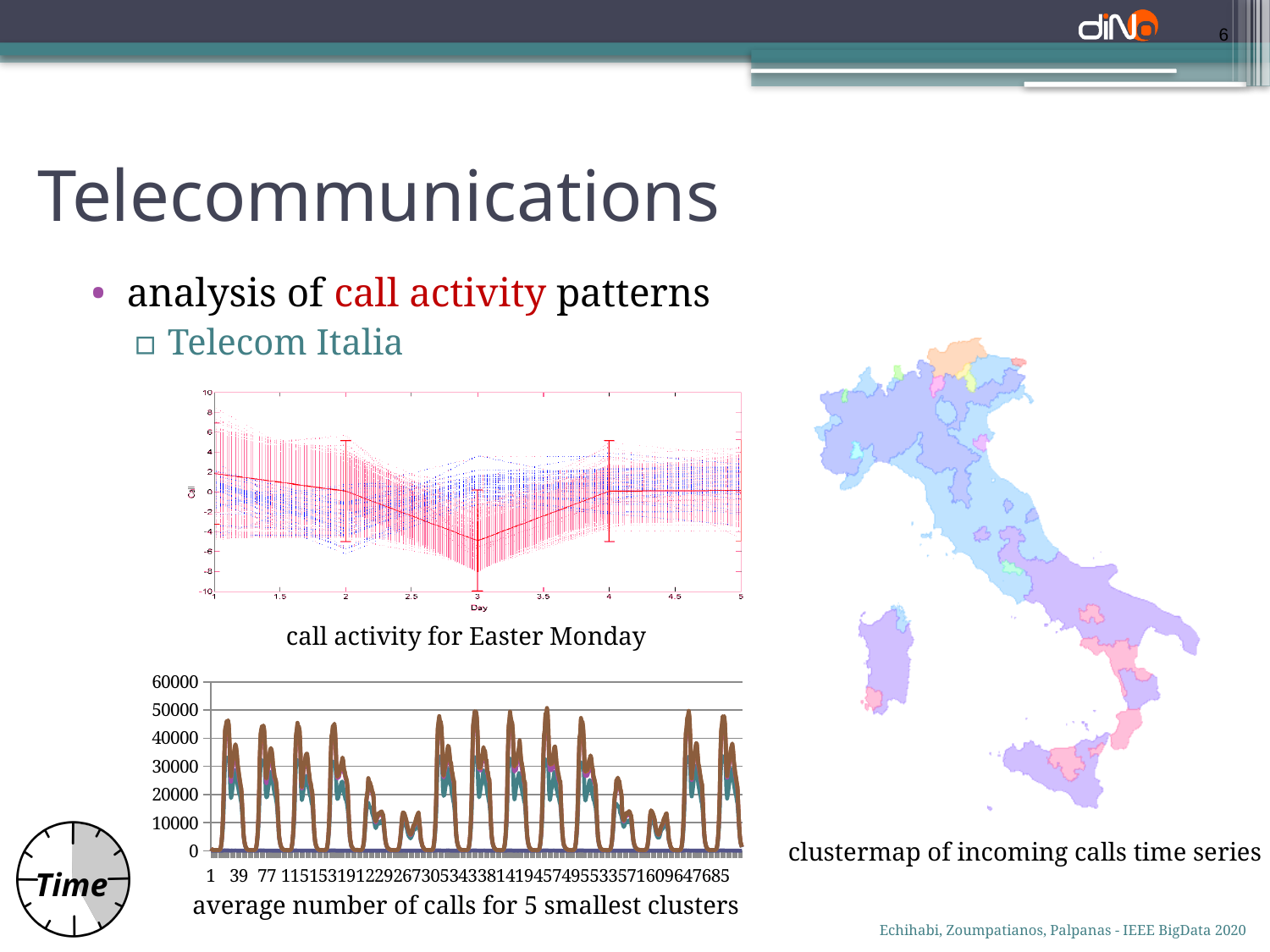
What is the x-axis label of the chart titled "call activity for Easter Monday"? Day In the chart titled "average number of calls for 5 smallest clusters", are the lowest troughs between peaks greater or less than 10000? less In the chart titled "call activity for Easter Monday", does the red line rise or fall between day 1 and day 3? fall In the chart titled "average number of calls for 5 smallest clusters", what is the highest value shown on the y axis? 60000 In the chart titled "call activity for Easter Monday", is the red line's value at day 3 greater or less than 0? less In the chart titled "average number of calls for 5 smallest clusters", what is the last label shown on the x axis? 685 In the chart titled "call activity for Easter Monday", at which day does the red line reach its lowest point? 3 In the chart titled "average number of calls for 5 smallest clusters", are the highest peaks greater or less than 60000? less What kind of chart is the chart titled "average number of calls for 5 smallest clusters"? line chart